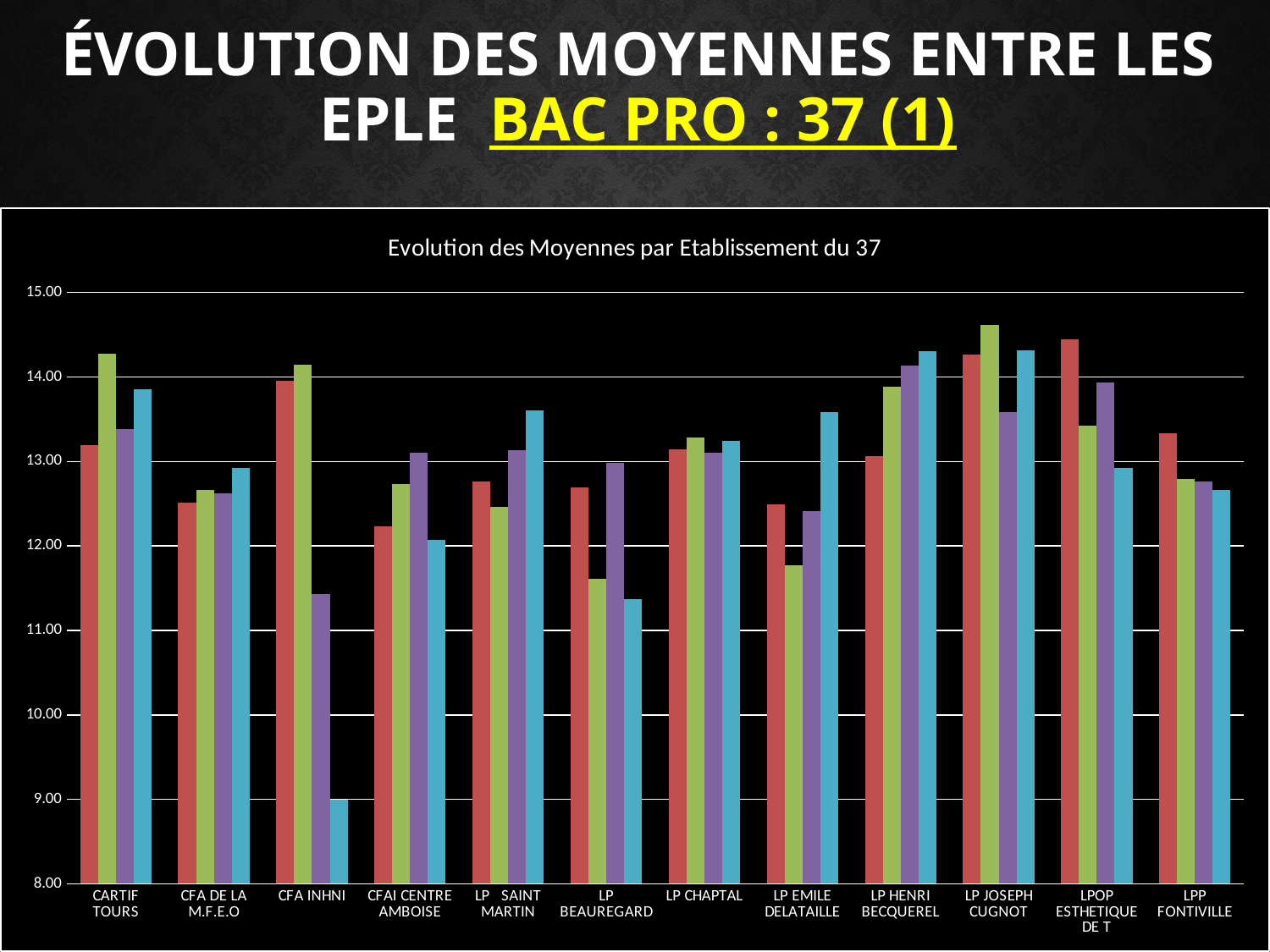
Is the value of the purple bar for CFA INHNI greater or less than 12.00? less For CFA INHNI, which is larger: the red bar or the blue bar? the red bar How many establishments (categories) are shown on the x axis of the chart? 12 Is the value of the green bar for LP BEAUREGARD greater or less than 12.00? less How many bars are plotted for each establishment in the chart? 4 Which establishment has the lowest bar in the chart? CFA INHNI Is the value of the green bar for LP JOSEPH CUGNOT greater or less than 14.00? greater What is the title of the chart? Evolution des Moyennes par Etablissement du 37 For CARTIF TOURS, which is larger: the red bar or the green bar? the green bar What kind of chart is shown on the slide? bar chart